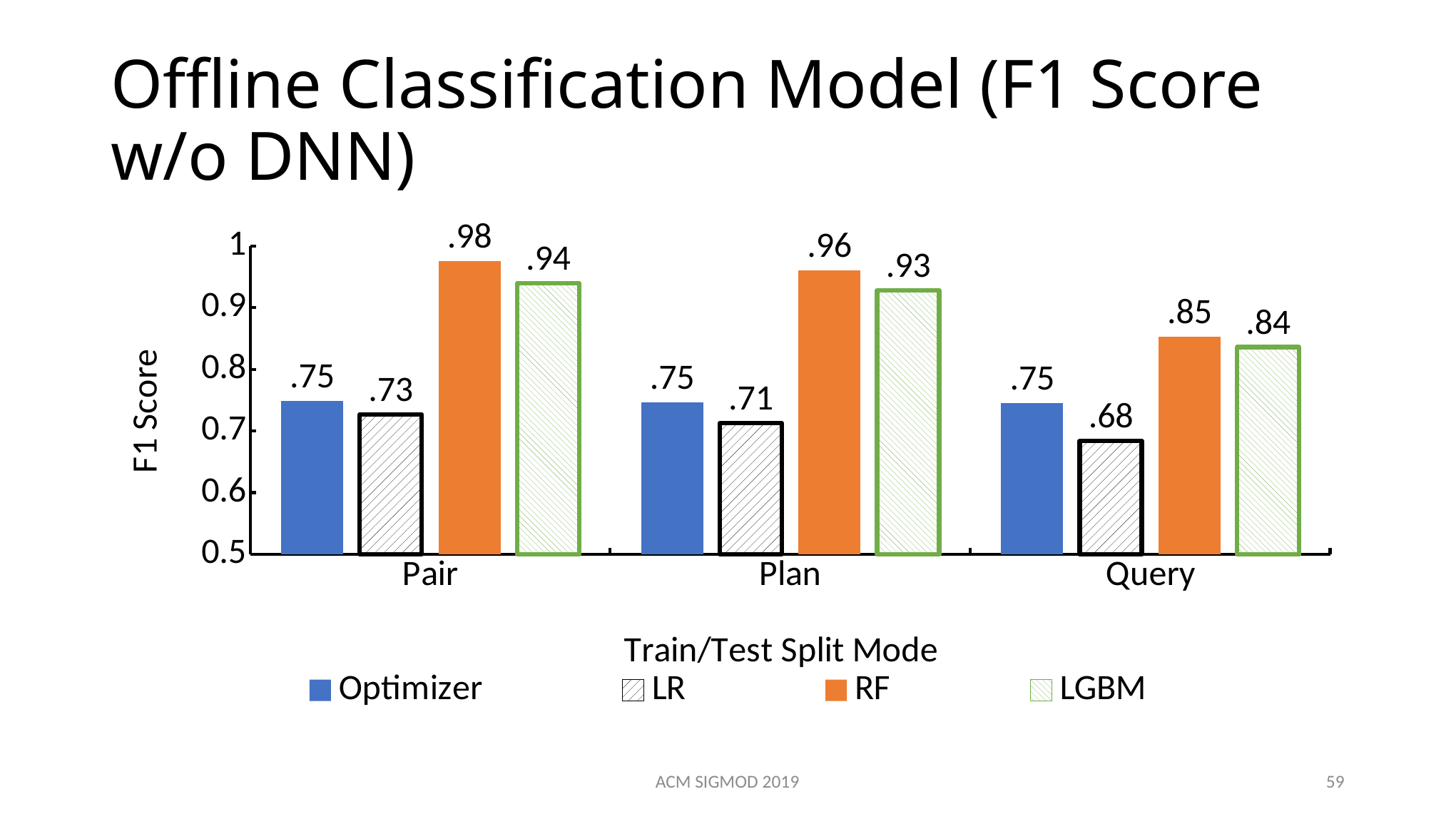
Which is larger, the LGBM F1 score for Pair or the LGBM F1 score for Query? Pair What is the F1 score for LR in the Query split mode? .68 Which series has the highest F1 score in the Query split mode? RF How many series does the legend list? 4 Which series has the lowest F1 score in the Plan split mode? LR What is the F1 score for LGBM in the Plan split mode? .93 Is the F1 score for Optimizer in the Plan split mode greater or less than 0.8? less What is the label of the y axis? F1 Score What is the F1 score for RF in the Pair split mode? .98 What kind of chart is shown on the slide? bar chart How many train/test split modes are shown on the x axis? 3 What is the difference between the RF and LR F1 scores in the Pair split mode? .25